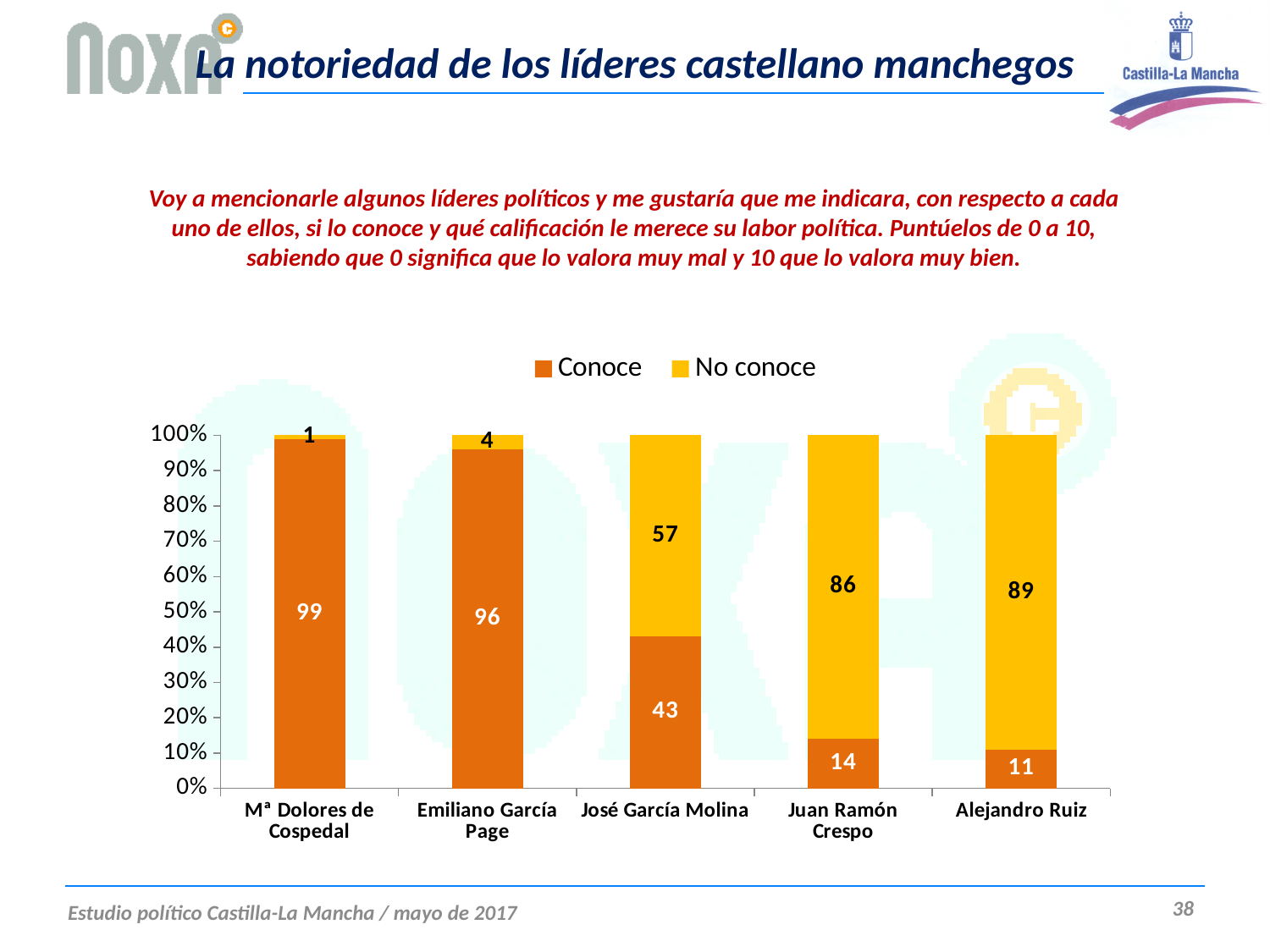
What is the total of the stacked bar for Emiliano García Page? 100 What is the 'No conoce' value for José García Molina? 57 What is the difference between the 'Conoce' values for Emiliano García Page and José García Molina? 53 How many leaders are shown on the x axis of the chart? 5 Which is larger: the 'No conoce' value for Juan Ramón Crespo or for Alejandro Ruiz? Alejandro Ruiz What is the 'Conoce' value for Mª Dolores de Cospedal? 99 Which leader has the highest 'Conoce' value? Mª Dolores de Cospedal How many series does the legend list? 2 What is the 'Conoce' value for Juan Ramón Crespo? 14 What kind of chart is shown on the slide? Stacked bar chart What is the 'No conoce' value for Alejandro Ruiz? 89 Which leader has the lowest 'Conoce' value? Alejandro Ruiz